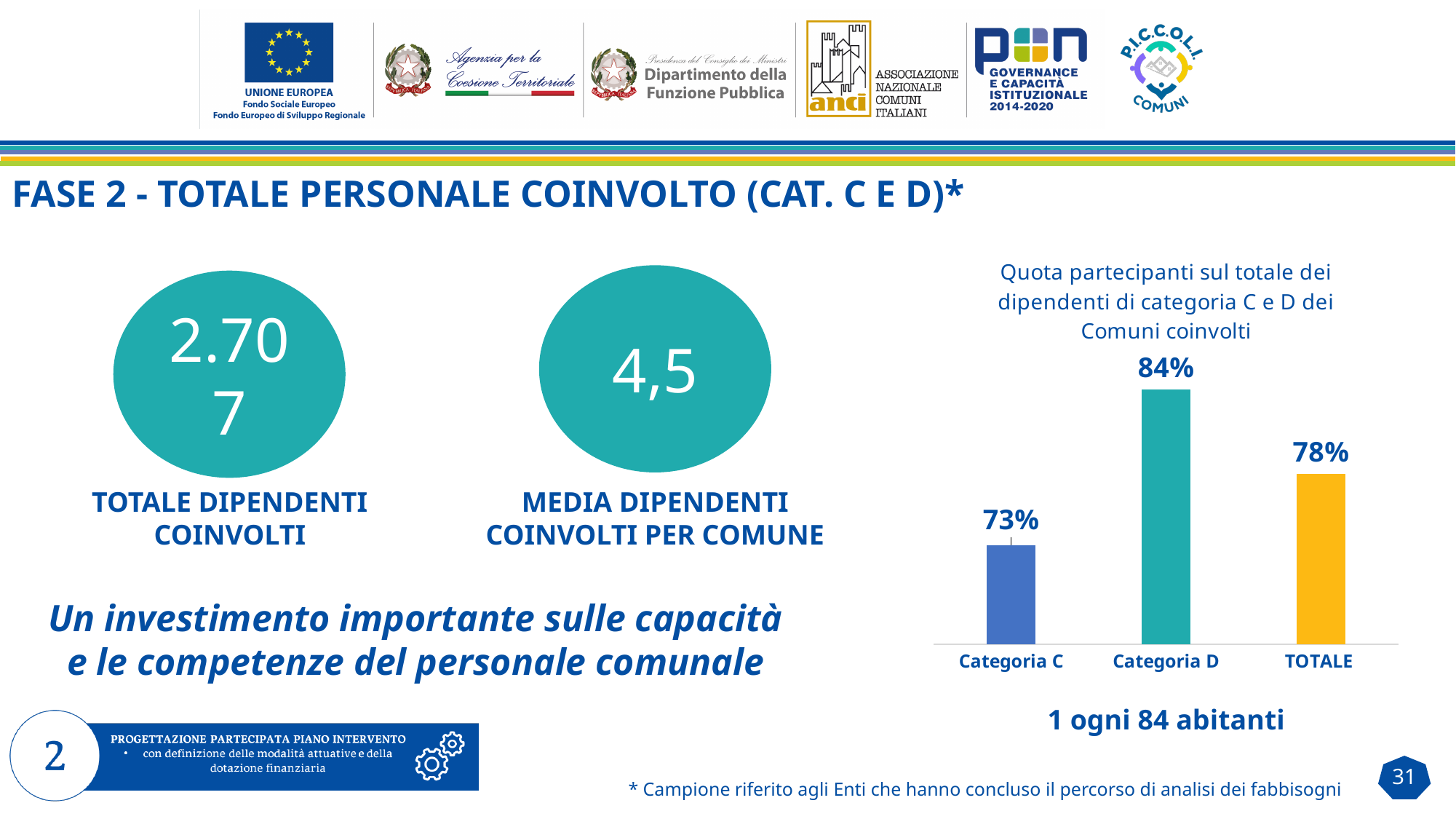
Which category has the lowest value in the chart? Categoria C What colour is the TOTALE bar in the chart? Yellow What is the difference between the values for Categoria D and Categoria C? 11% What is the value for Categoria C in the chart? 73% Which is larger, the value for Categoria C or the value for TOTALE? TOTALE What is the title of the chart? Quota partecipanti sul totale dei dipendenti di categoria C e D dei Comuni coinvolti Which category has the highest value in the chart? Categoria D What is the difference between the values for Categoria D and TOTALE? 6% How many categories are shown in the chart? 3 What kind of chart is shown on the slide? Bar chart What is the value for TOTALE in the chart? 78% What is the value for Categoria D in the chart? 84%